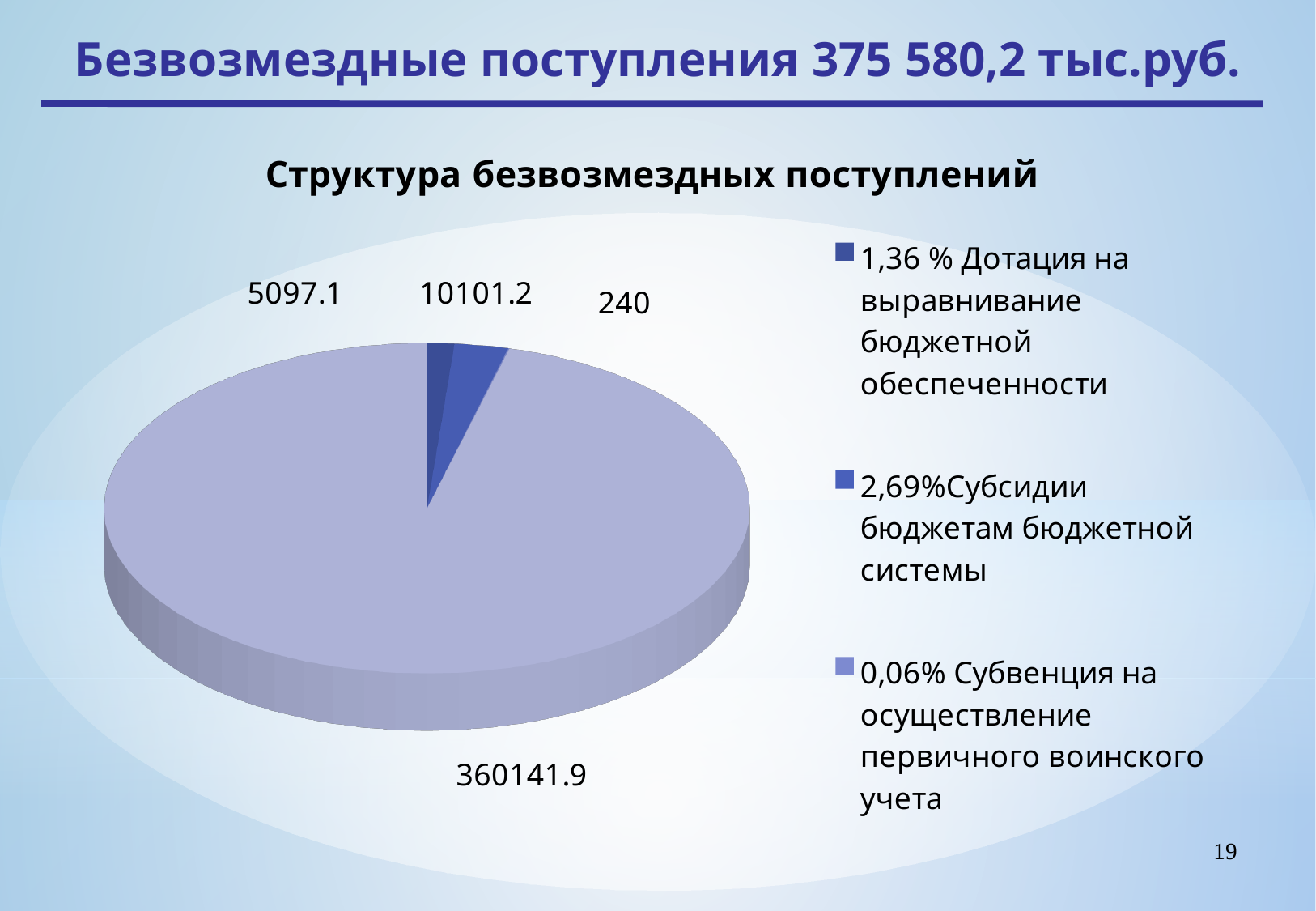
What is the value for Субвенция на осуществление первичного воинского учета? 240 What is the value for Субсидии бюджетам бюджетной системы? 10101.2 Which slice of the pie has the largest value? 360141.9 How many data labels are shown on the pie chart? 4 What is the value for Дотация на выравнивание бюджетной обеспеченности? 5097.1 What kind of chart is shown on the slide? pie chart Which is larger: the value for Субсидии бюджетам бюджетной системы or the value for Дотация на выравнивание бюджетной обеспеченности? Субсидии бюджетам бюджетной системы What is the smallest value labelled on the pie chart? 240 What share of the pie does Субвенция на осуществление первичного воинского учета represent, according to the legend? 0,06% What is the title of the chart? Структура безвозмездных поступлений How many entries does the legend list? 3 What is the difference between the values 10101.2 and 5097.1 shown on the pie chart? 5004.1